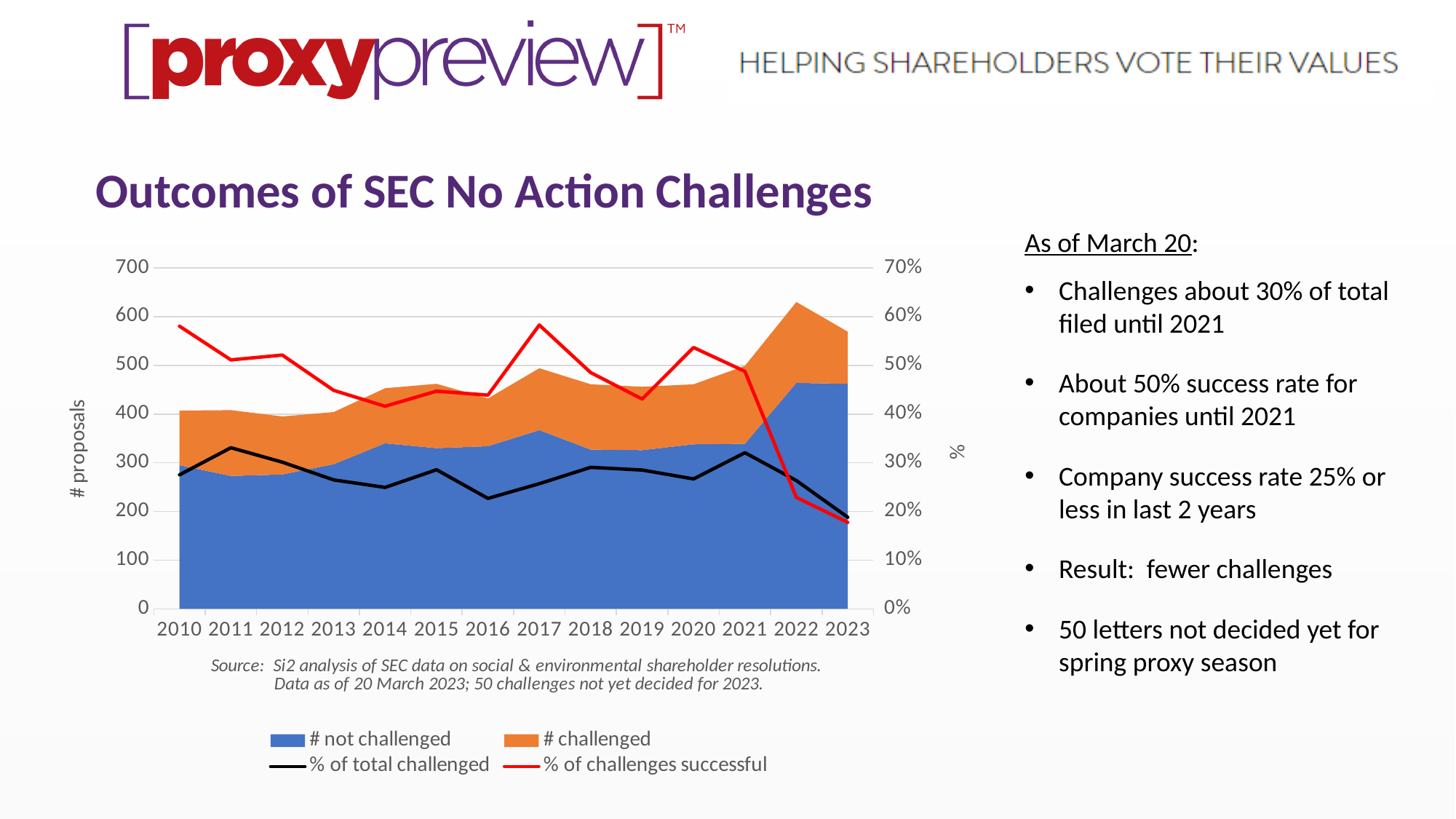
Does the '% of challenges successful' line rise or fall from 2021 to 2023? fall Is the value for '% of total challenged' in 2016 greater or less than 30%? less In which year does the total number of proposals (top of the stacked area) reach its highest? 2022 How many years are shown along the x axis? 14 Is the value for '% of challenges successful' in 2010 greater or less than 50%? greater How many series does the legend list? 4 Is the value for '# not challenged' in 2022 greater or less than 400? greater What is the label on the left vertical axis? # proposals What kind of chart is shown on the slide? A combination chart with stacked areas and lines Which is larger: '% of challenges successful' in 2010 or in 2023? 2010 In which year is the '% of challenges successful' line at its lowest? 2023